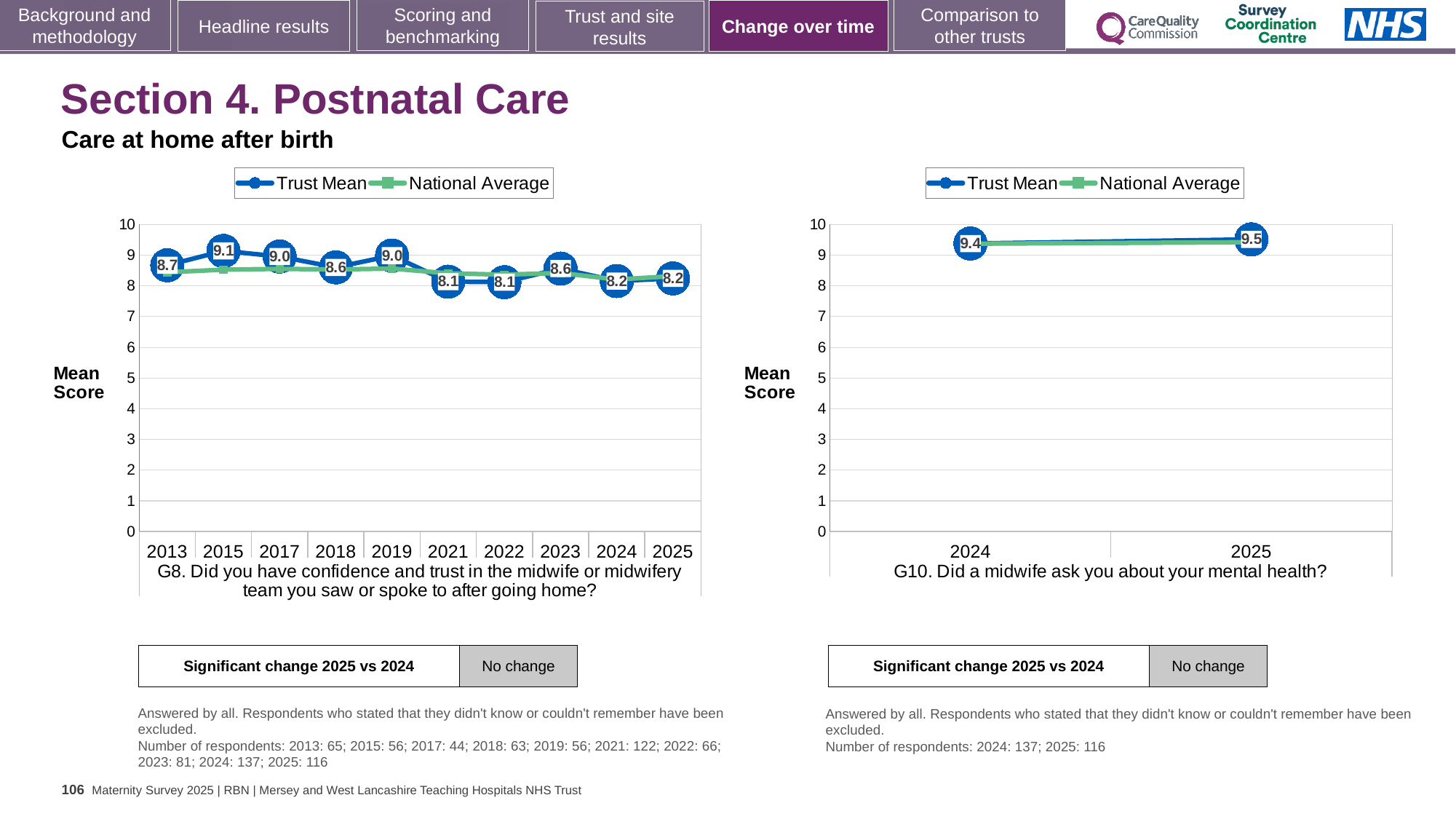
On the G8 chart (left), what is the difference between the Trust Mean in 2015 and in 2025? 0.9 What kind of chart is the G10 chart (right)? line chart On the G8 chart (left), which is larger, the Trust Mean in 2019 or in 2021? 2019 On the G8 chart (left), what is the Trust Mean score for 2015? 9.1 On the G8 chart (left), does the Trust Mean overall rise or fall from 2013 to 2025? fall On the G10 chart (right), what is the Trust Mean score for 2024? 9.4 On the G8 chart (left), how many years are plotted on the x axis? 10 On the G8 chart (left), what is the Trust Mean score for 2025? 8.2 On the G8 chart (left), in which year is the Trust Mean highest? 2015 On the G8 chart (left), is the National Average value for 2013 greater or less than 9? less How many series does the legend of the G10 chart (right) list? 2 On the G10 chart (right), what is the difference between the Trust Mean in 2025 and in 2024? 0.1